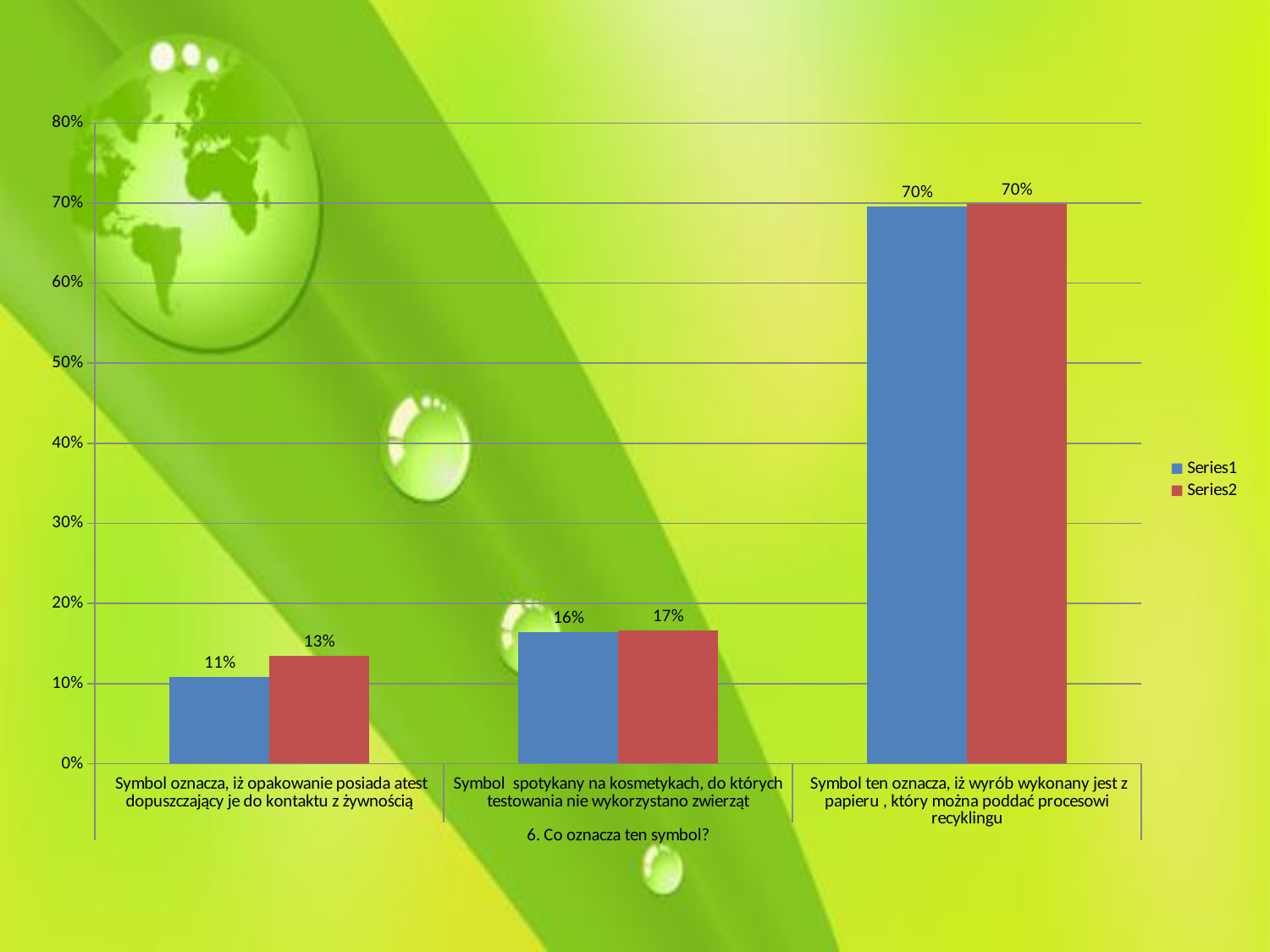
What is the Series1 value for "Symbol oznacza, iż opakowanie posiada atest dopuszczający je do kontaktu z żywnością"? 11% How many series does the legend list? 2 Do the Series1 values rise or fall from left to right along the x axis? rise What type of chart is shown on the slide? bar chart What is the Series2 value for "Symbol spotykany na kosmetykach, do których testowania nie wykorzystano zwierząt"? 17% Which is larger for "Symbol spotykany na kosmetykach, do których testowania nie wykorzystano zwierząt": Series1 or Series2? Series2 What is the Series1 value for "Symbol ten oznacza, iż wyrób wykonany jest z papieru, który można poddać procesowi recyklingu"? 70% What is the difference between the Series2 and Series1 values for "Symbol oznacza, iż opakowanie posiada atest dopuszczający je do kontaktu z żywnością"? 2% How many categories are shown on the x axis? 3 Which category has the highest Series2 value? Symbol ten oznacza, iż wyrób wykonany jest z papieru, który można poddać procesowi recyklingu What text appears as the horizontal axis title below the categories? 6. Co oznacza ten symbol? Which category has the lowest Series1 value? Symbol oznacza, iż opakowanie posiada atest dopuszczający je do kontaktu z żywnością